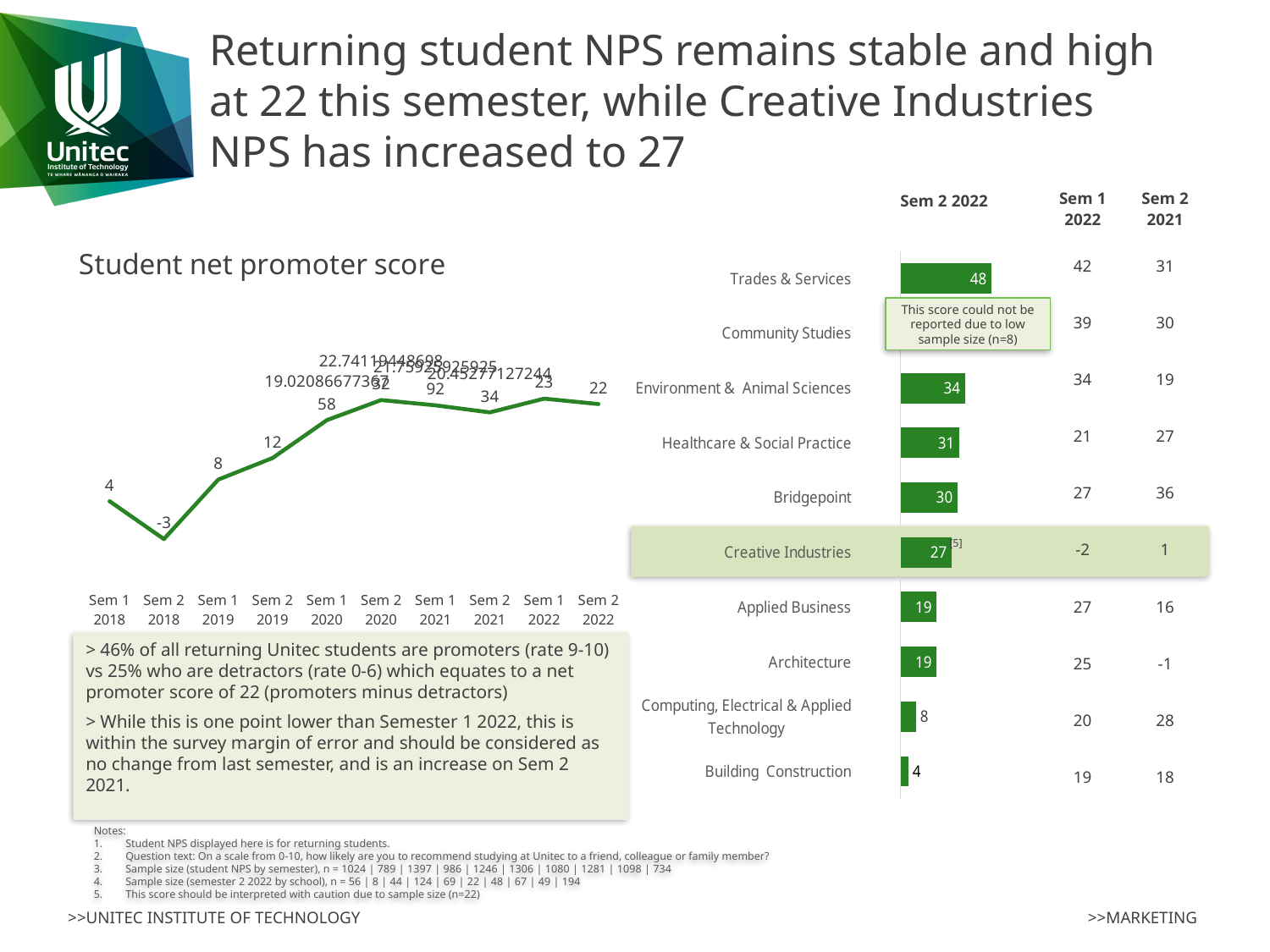
In the 'Student net promoter score' line chart, what is the value for Sem 2 2022? 22 In the bar chart on the right, which is larger: the value for Healthcare & Social Practice or the value for Bridgepoint? Healthcare & Social Practice In the 'Student net promoter score' line chart, what is the value for Sem 2 2018? -3 In the bar chart on the right, what is the Sem 2 2022 value for Trades & Services? 48 In the 'Student net promoter score' line chart, which semester has the lowest value? Sem 2 2018 What kind of chart is the 'Student net promoter score' chart on the left of the slide? line chart In the bar chart on the right, what is the difference between the Trades & Services value and the Building Construction value? 44 In the bar chart on the right, which school has the highest Sem 2 2022 value? Trades & Services What kind of chart is the chart on the right showing Sem 2 2022 scores by school? bar chart In the bar chart on the right, which school's score could not be reported due to low sample size? Community Studies In the bar chart on the right, which school has the lowest Sem 2 2022 value? Building Construction In the 'Student net promoter score' line chart, what is the difference between the Sem 1 2022 value and the Sem 2 2022 value? 1